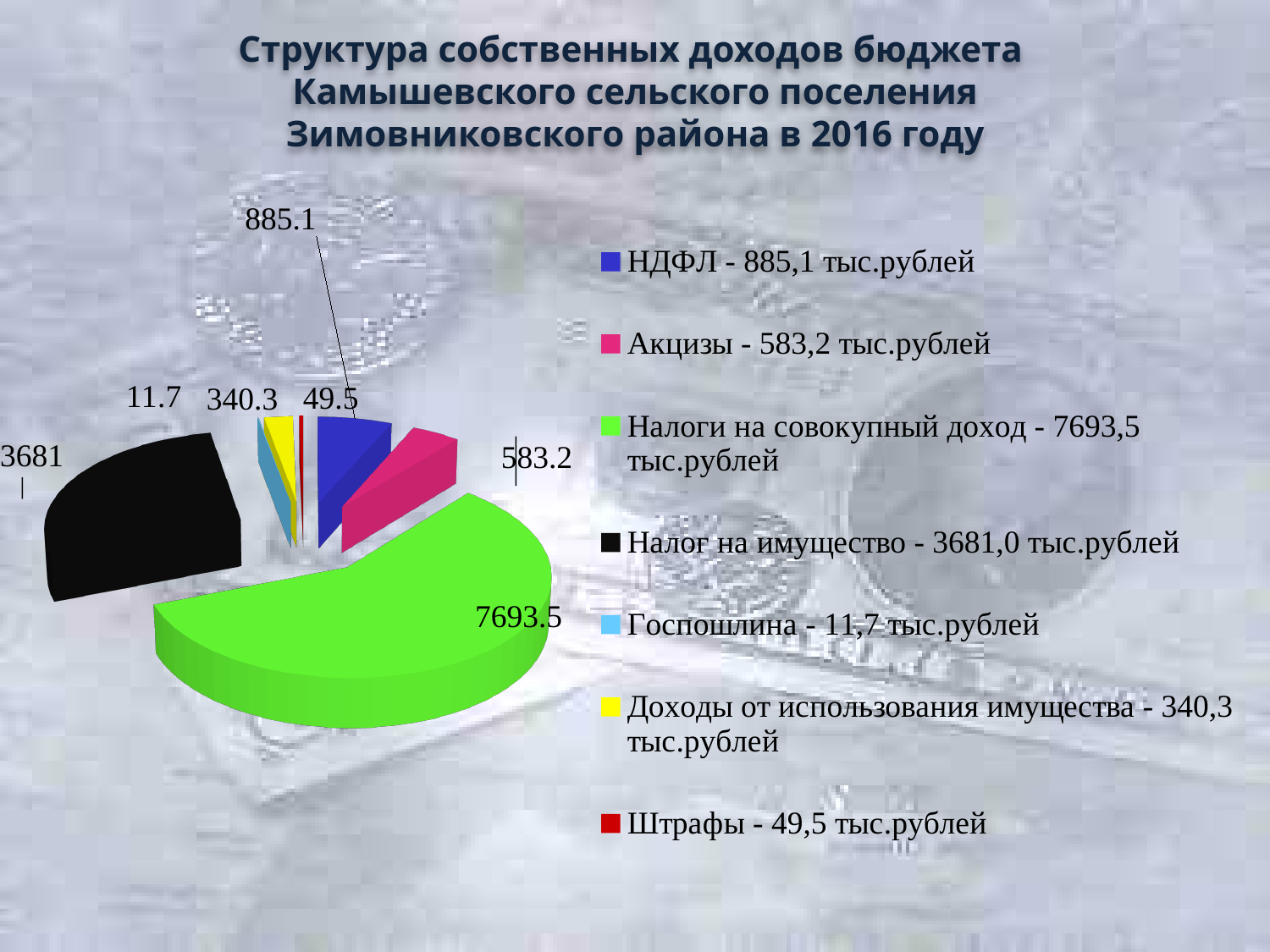
What is the difference between the Доходы от использования имущества value (340.3) and the Штрафы value (49.5)? 290.8 What is the value of the Госпошлина slice? 11.7 What is the value of the НДФЛ slice? 885.1 Which is larger, Налог на имущество or НДФЛ? Налог на имущество What is the value of the Акцизы slice? 583.2 How many slices does the pie chart have? 7 What is the difference between the Налог на имущество value (3681) and the НДФЛ value (885.1)? 2795.9 What type of chart is shown on the slide? pie chart What is the value of the Штрафы slice? 49.5 Which category has the largest slice of the pie? Налоги на совокупный доход Which category has the smallest slice of the pie? Госпошлина What colour is the slice for Налоги на совокупный доход? green